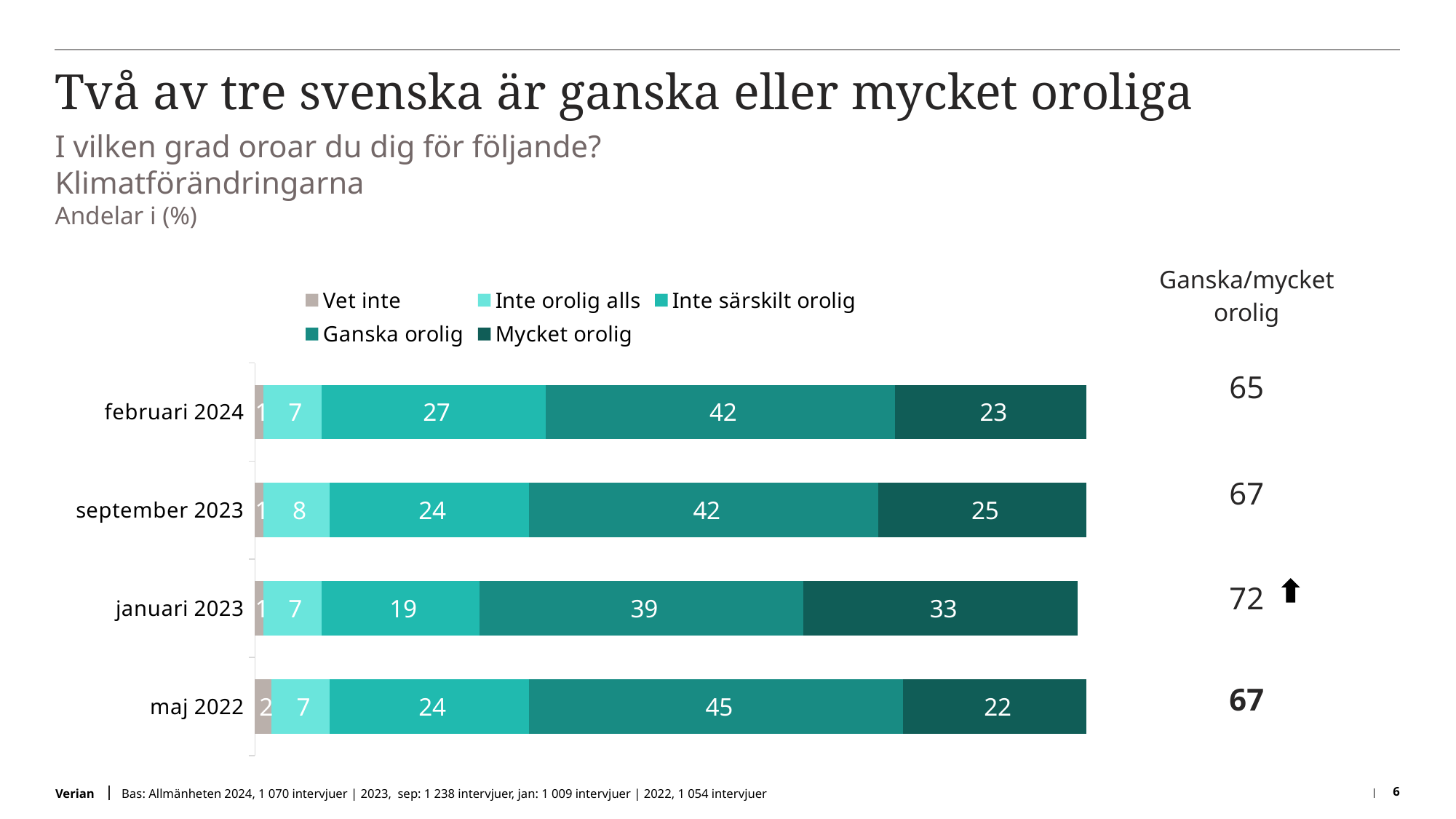
What is the value for Inte särskilt orolig in februari 2024? 27 How many periods are shown on the chart? 4 Which period has the lowest value for Inte särskilt orolig? januari 2023 How many series does the legend list? 5 Which is larger, the Ganska orolig value for maj 2022 or for januari 2023? maj 2022 What kind of chart is shown on the slide? stacked bar chart What Ganska/mycket orolig value is shown to the right of the januari 2023 bar? 72 What is the value for Mycket orolig in januari 2023? 33 What is the value for Ganska orolig in maj 2022? 45 What is the total of the stacked bar for januari 2023? 99 What is the difference between the Mycket orolig values for september 2023 and februari 2024? 2 Which period has the highest value for Mycket orolig? januari 2023